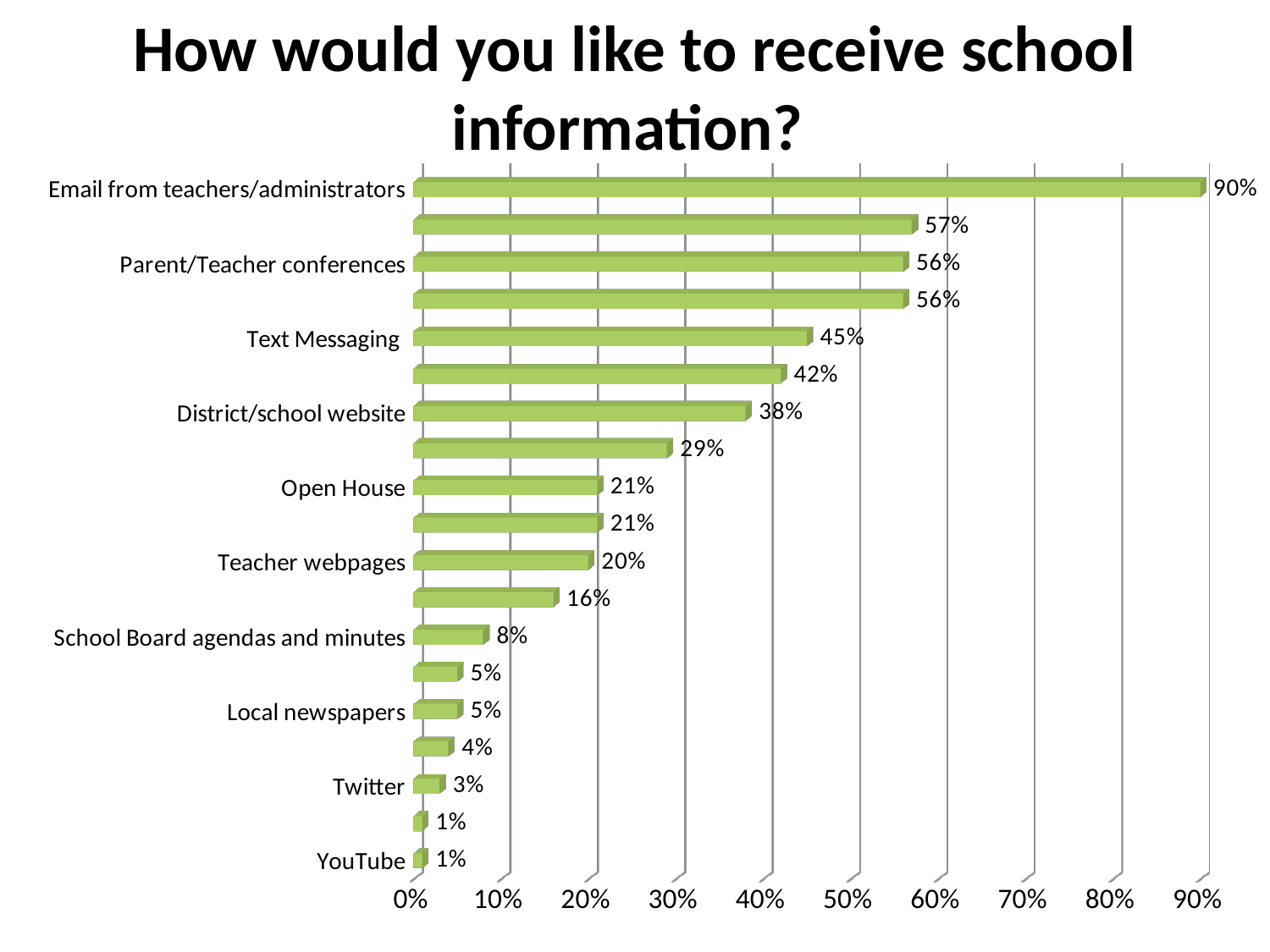
What is the value for Text Messaging? 45% What is the value for Parent/Teacher conferences? 56% Is the value for District/school website greater or less than 40%? less How many bars are plotted on the chart? 19 What is the lowest value shown on the chart? 1% What is the difference between Email from teachers/administrators and Parent/Teacher conferences? 34 percentage points Which category has the highest value? Email from teachers/administrators Which is larger, Text Messaging or District/school website? Text Messaging What percentage of respondents chose Email from teachers/administrators? 90% What kind of chart is shown? Bar chart What is the value for School Board agendas and minutes? 8% What is the title of the chart? How would you like to receive school information?